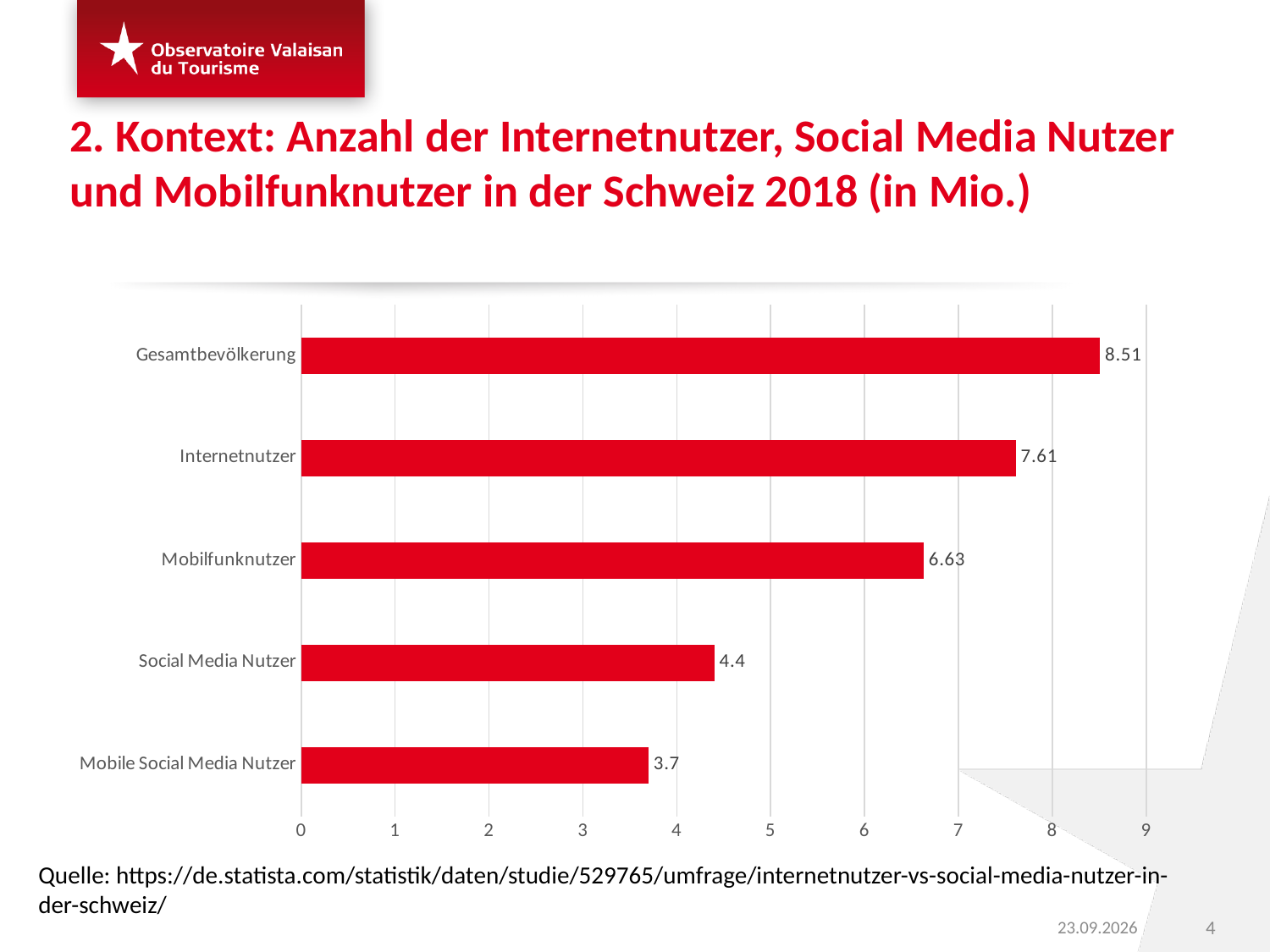
Which category has the lowest value? Mobile Social Media Nutzer What is the value for Internetnutzer? 7.61 Which is larger, the value for Mobilfunknutzer or the value for Social Media Nutzer? Mobilfunknutzer Which category has the highest value? Gesamtbevölkerung What is the difference between the values for Internetnutzer and Social Media Nutzer? 3.21 What is the value for Gesamtbevölkerung? 8.51 What is the value for Mobile Social Media Nutzer? 3.7 Is the value for Mobilfunknutzer greater or less than 6? greater What is the value for Mobilfunknutzer? 6.63 How many categories are shown in the chart? 5 What kind of chart is shown on the slide? bar chart What is the value for Social Media Nutzer? 4.4